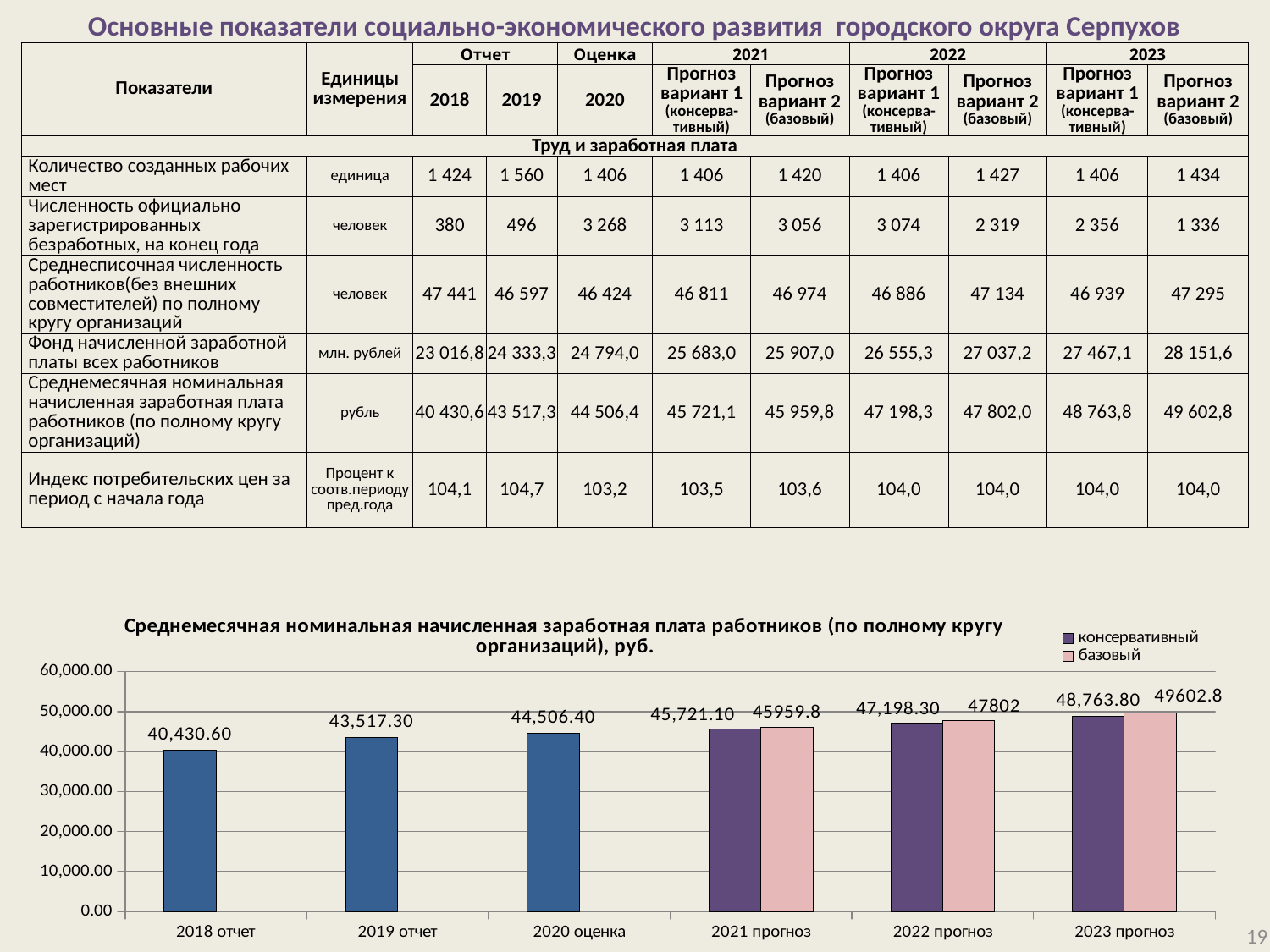
Which bar is the highest in the chart? базовый for 2023 прогноз How many categories are shown on the x axis of the chart? 6 What is the value of the консервативный bar for 2023 прогноз? 48,763.80 What is the value of the базовый bar for 2021 прогноз? 45959.8 What is the value of the bar for 2018 отчет? 40,430.60 Which category has the lowest bar in the chart? 2018 отчет What type of chart is shown on the slide? bar chart What is the value of the bar for 2020 оценка? 44,506.40 Do the консервативный values rise or fall from 2018 отчет to 2023 прогноз? rise What is the difference between the базовый and консервативный values for 2022 прогноз? 603.7 How many series does the chart legend list? 2 Which is larger for 2022 прогноз: the консервативный bar or the базовый bar? базовый